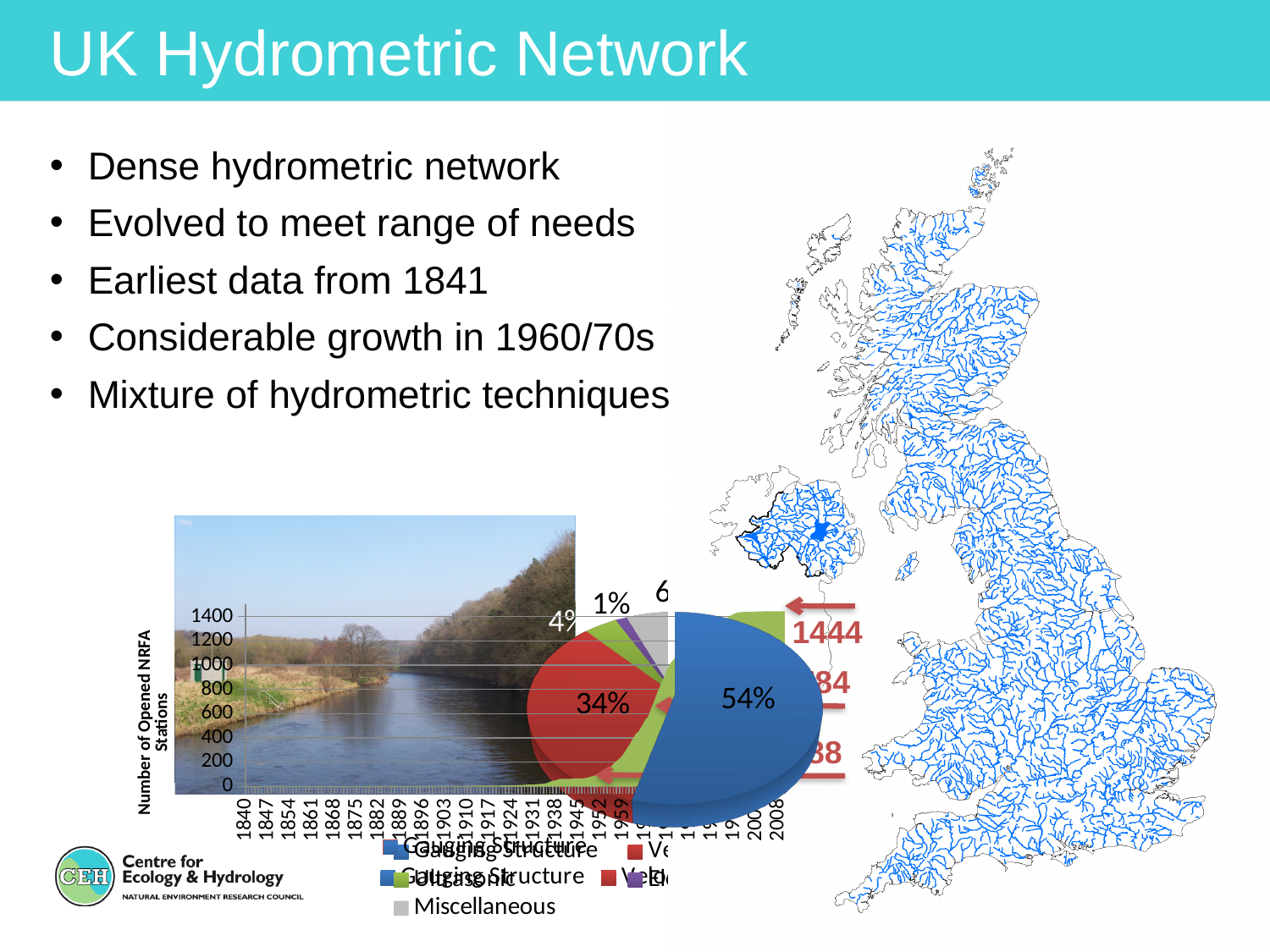
In the pie chart, what is the difference in percentage points between the 54% slice and the 34% slice? 20 percentage points What kind of chart is the chart on the right showing percentages (54%, 34%)? pie chart What is the highest value shown on the y-axis of the chart on the left showing stations over time? 1400 In the pie chart, what colour is the 54% slice? blue In the pie chart, is the share of the blue slice greater or less than 50%? greater What is the first year shown on the x-axis of the chart on the left showing stations over time? 1840 In the pie chart, which slice is larger, the blue slice or the red slice? the blue slice In the pie chart, which legend entry is shown with a blue marker? Gauging Structure In the pie chart, what is the share of the smallest labelled slice? 1% In the pie chart, what is the share of the red slice? 34% What is the y-axis title of the chart on the left showing stations over time? Number of Opened NRFA Stations In the pie chart, what is the share of the largest slice? 54%